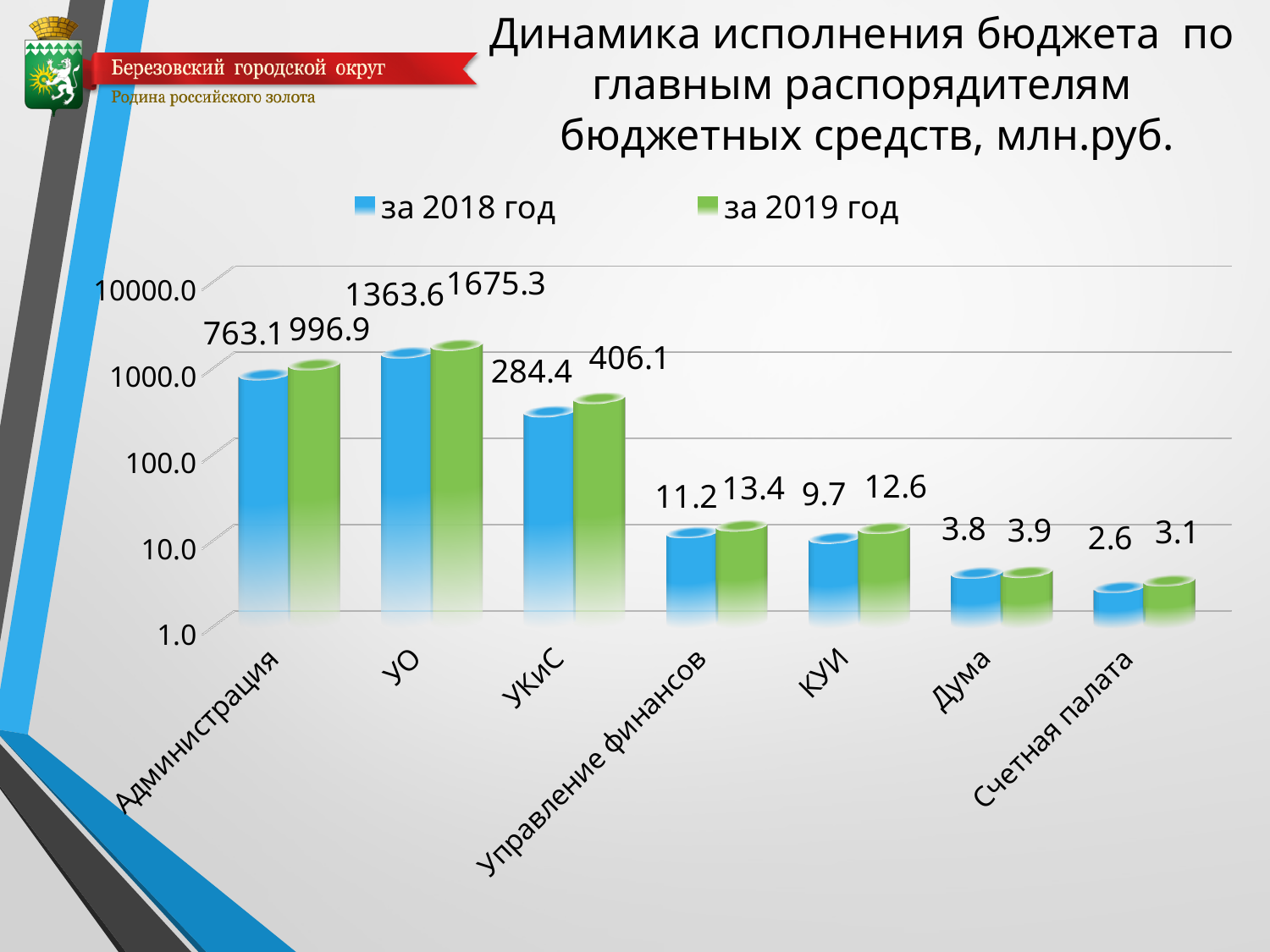
What is the value for КУИ for за 2018 год? 9.7 What is the value for УО for за 2019 год? 1675.3 Which category has the lowest value for за 2019 год? Счетная палата Which colour represents the series за 2019 год? green What is the value for Счетная палата for за 2019 год? 3.1 What is the difference between the за 2019 год and за 2018 год values for УКиС? 121.7 Which is larger for Управление финансов: the value for за 2018 год or за 2019 год? за 2019 год What is the value for Администрация for за 2018 год? 763.1 What kind of chart is shown on the slide? bar chart Which category has the highest value for за 2018 год? УО How many categories are shown on the x axis? 7 How many series does the legend list? 2